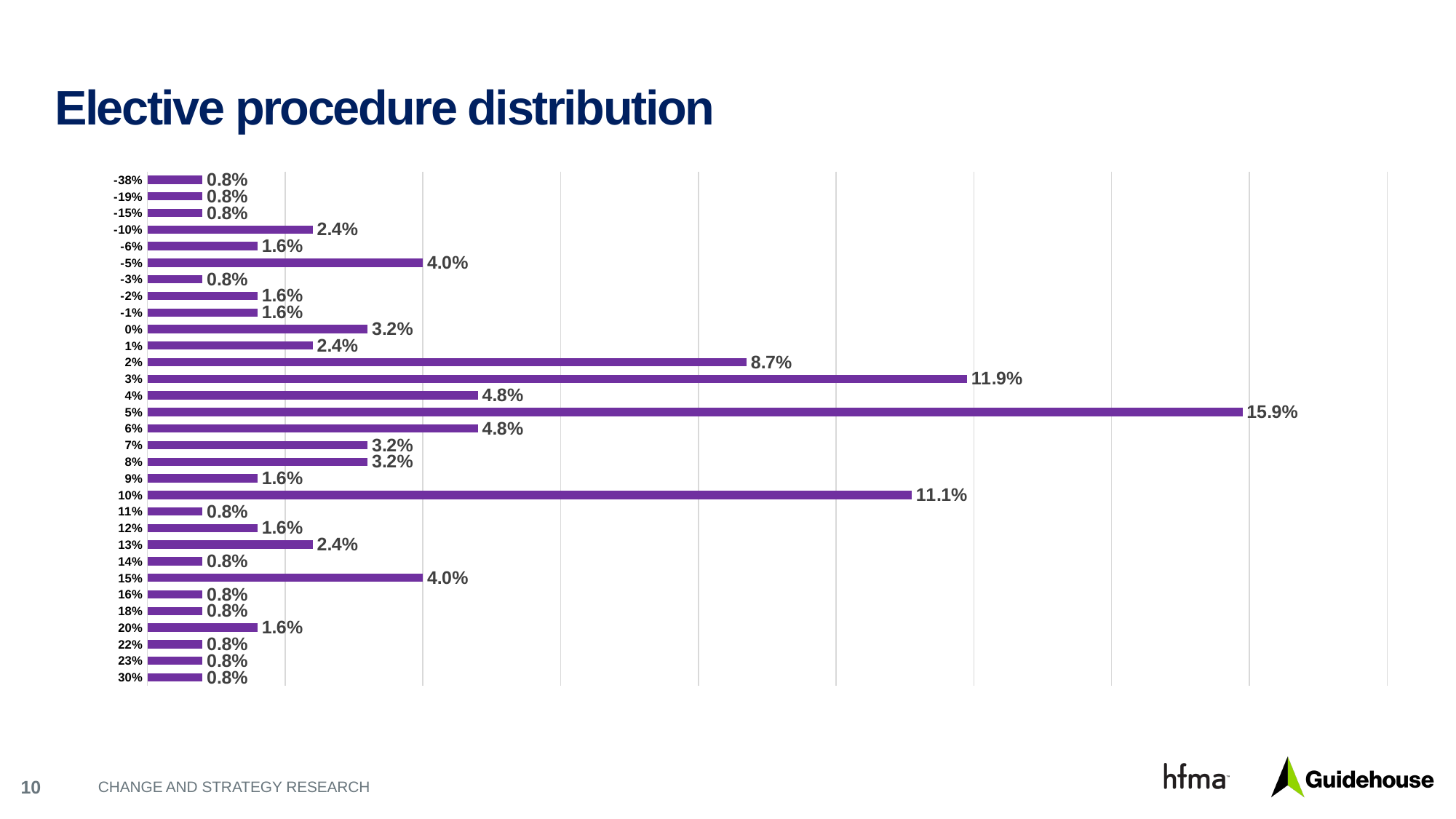
Which is larger, the value for the 2% category or the value for the 4% category? 2% Which category has the highest value? 5% What is the title of the chart? Elective procedure distribution What is the value for the 15% category? 4.0% What kind of chart is shown on the slide? Bar chart What is the value for the -10% category? 2.4% How many categories are shown on the chart? 31 What is the value for the 10% category? 11.1% What is the lowest value shown on the chart? 0.8% What is the difference between the values for the 5% and 3% categories? 4.0% What is the difference between the values for the 10% and 2% categories? 2.4% What is the value for the 5% category? 15.9%